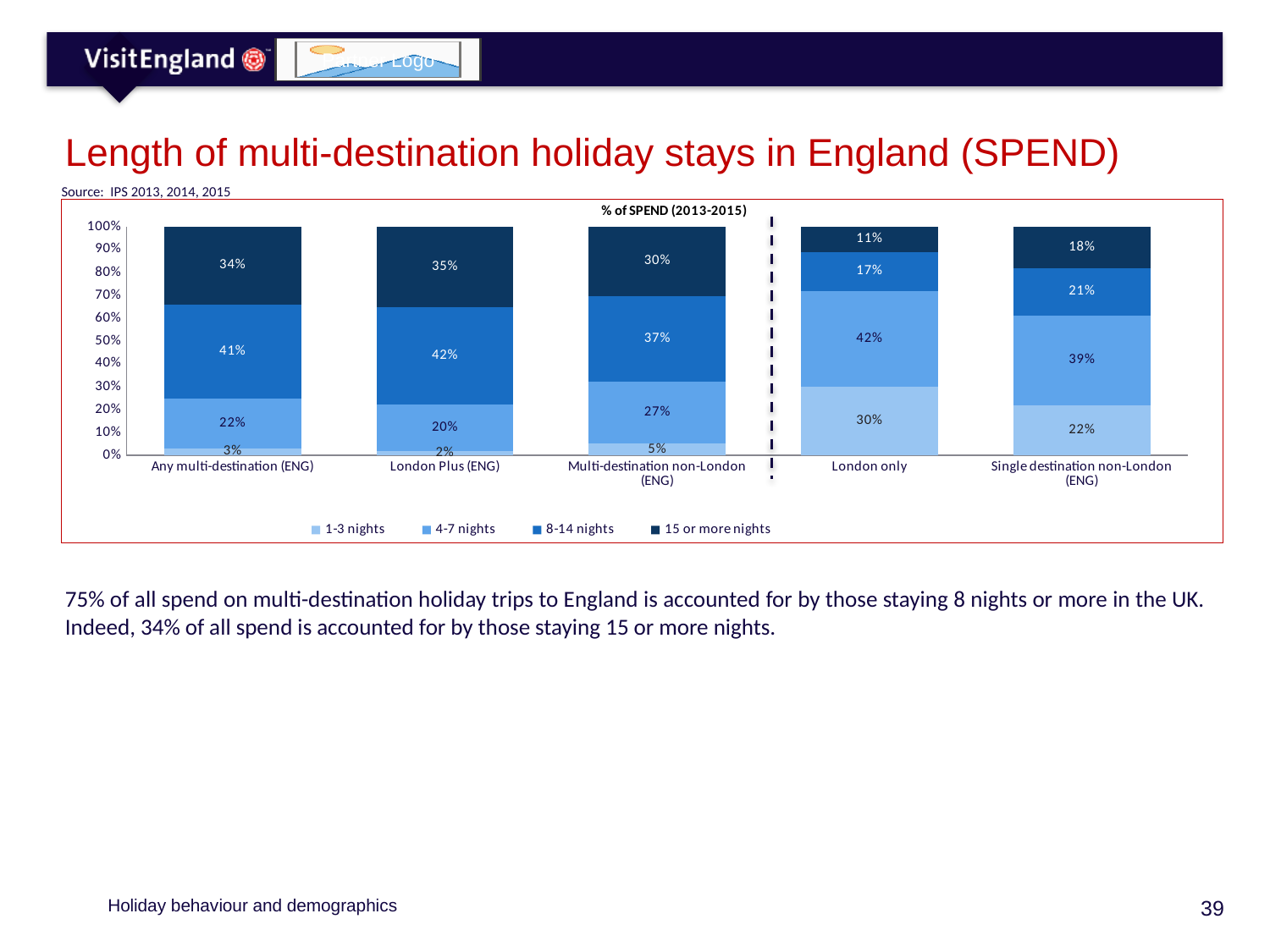
What is the 1-3 nights share of spend for Single destination non-London (ENG)? 22% What is the difference between the 8-14 nights share for London Plus (ENG) and for London only? 25 percentage points What percentage of spend for London Plus (ENG) comes from stays of 15 or more nights? 35% What is the title printed above the chart's plot area? % of SPEND (2013-2015) Which category has the lowest share of spend from 15 or more nights stays? London only How many categories are shown on the x axis? 5 What is the 8-14 nights share of spend for Multi-destination non-London (ENG)? 37% What kind of chart is shown on the slide? Stacked bar chart Which category has the highest share of spend from 1-3 nights stays? London only What is the 4-7 nights share of spend for London only? 42% How many series does the legend list? 4 Which is larger: the 15 or more nights share for Any multi-destination (ENG) or for Single destination non-London (ENG)? Any multi-destination (ENG)